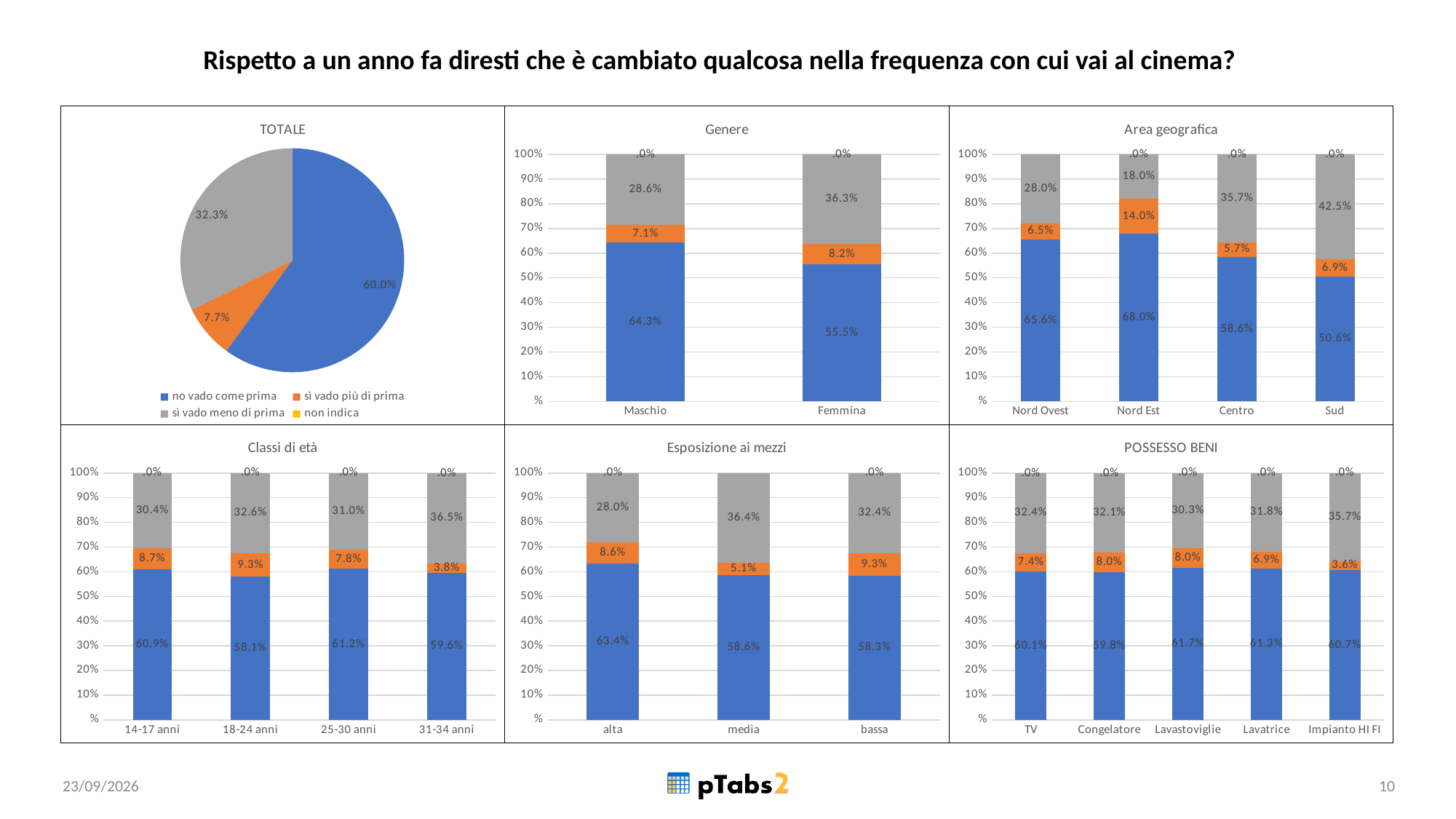
In the Classi di età chart, what is the "sì vado più di prima" value for 31-34 anni? 3.8% In the Area geografica chart, what is the difference between the "no vado come prima" values for Nord Est and Sud? 17.4 percentage points In the Genere chart, which has the larger "no vado come prima" value, Maschio or Femmina? Maschio In the TOTALE pie chart, what is the value for "sì vado più di prima"? 7.7% In the Area geografica chart, what is the "sì vado meno di prima" value for Sud? 42.5% In the Genere chart, what is the "sì vado meno di prima" value for Femmina? 36.3% In the TOTALE pie chart, what share of respondents answered "no vado come prima"? 60.0% What kind of chart is the TOTALE chart? Pie chart How many age groups are shown in the Classi di età chart? 4 In the Esposizione ai mezzi chart, which category has the highest "no vado come prima" value? alta In the Genere chart, what is the "no vado come prima" value for Maschio? 64.3% In the Area geografica chart, which area has the highest "no vado come prima" value? Nord Est